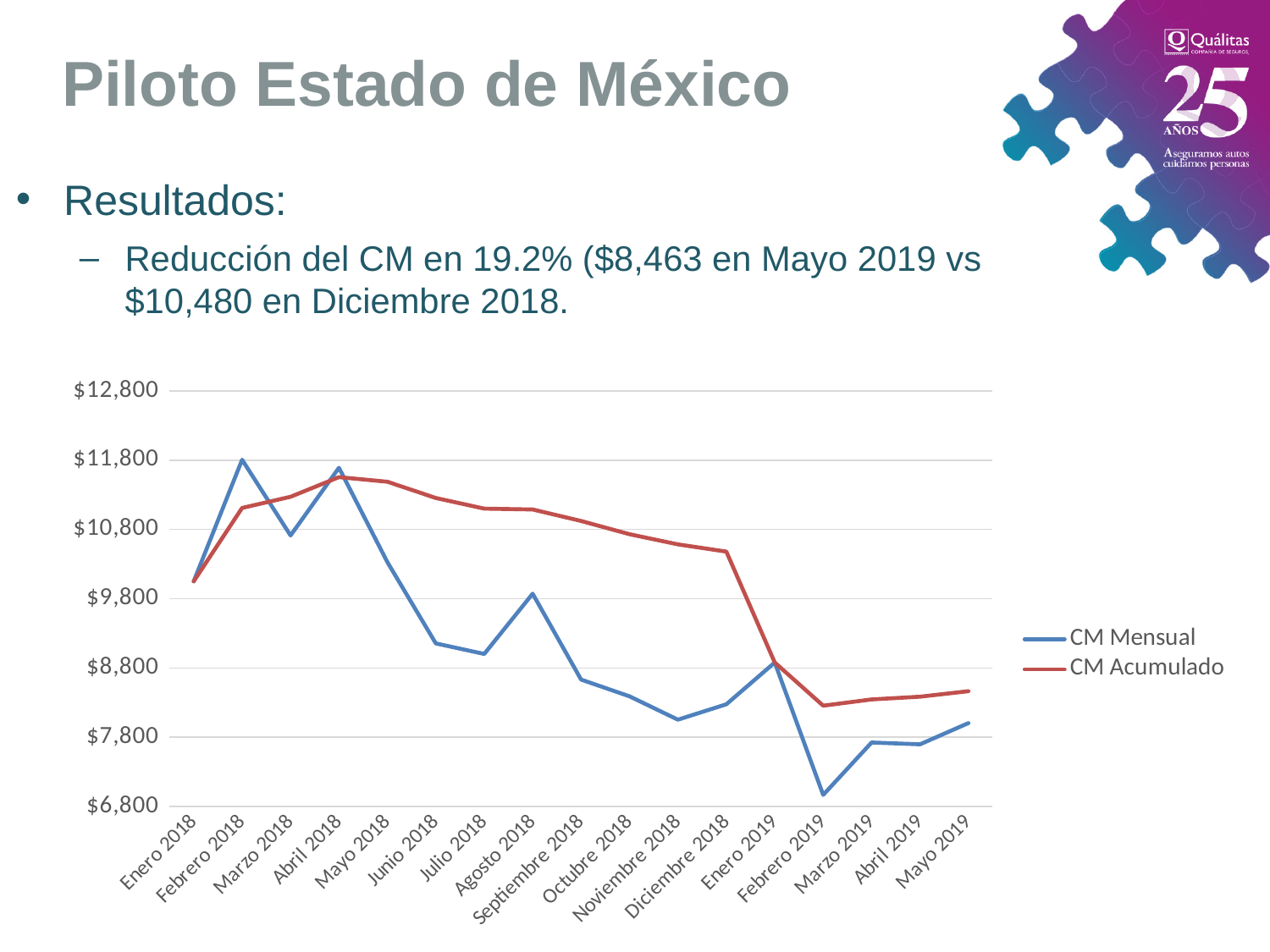
What kind of chart is shown on the slide? line chart Is the CM Mensual value for Junio 2018 greater or less than $8,800? greater What colour is the CM Mensual line? blue Does the CM Acumulado series rise or fall between Mayo 2018 and Febrero 2019? fall How many months are plotted along the x axis? 17 Is the CM Acumulado value for Diciembre 2018 greater or less than $9,800? greater At Agosto 2018, which series has the higher value, CM Mensual or CM Acumulado? CM Acumulado Is the CM Mensual value for Febrero 2019 greater or less than $7,800? less How many series does the legend list? 2 At Febrero 2019, which series has the higher value, CM Mensual or CM Acumulado? CM Acumulado In which month does the CM Mensual series reach its lowest value? Febrero 2019